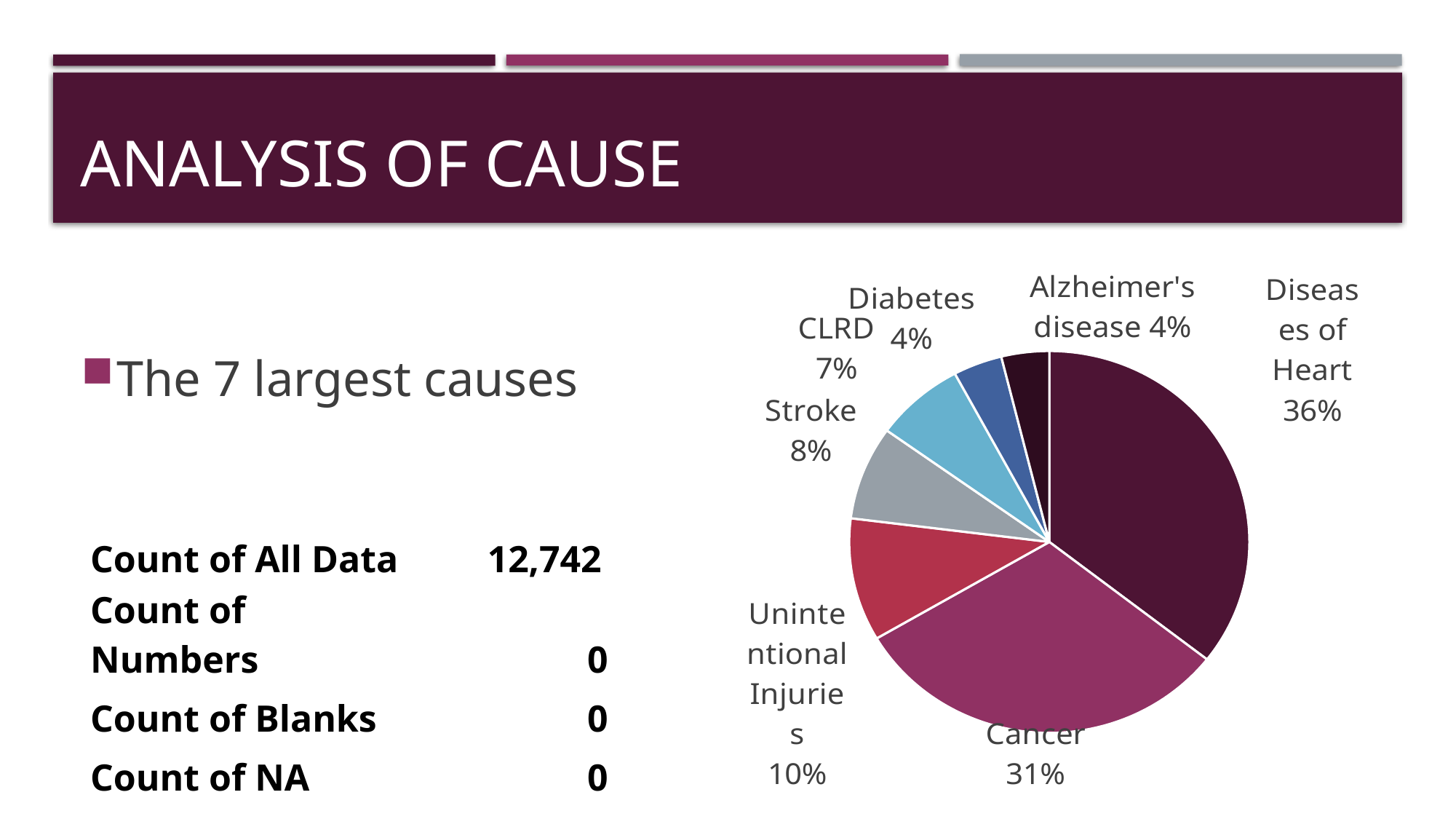
What share of the pie does Diseases of Heart have? 36% What share of the pie does Stroke have? 8% What share of the pie does CLRD have? 7% What colour is the Cancer slice of the pie? magenta/purple What is the difference in percentage points between Diseases of Heart and Cancer? 5% Which cause has the largest slice of the pie? Diseases of Heart Which is larger, the share for Stroke or the share for CLRD? Stroke What is the difference in percentage points between Unintentional Injuries and Alzheimer's disease? 6% How many slices does the pie chart have? 7 What kind of chart is shown on the slide? pie chart